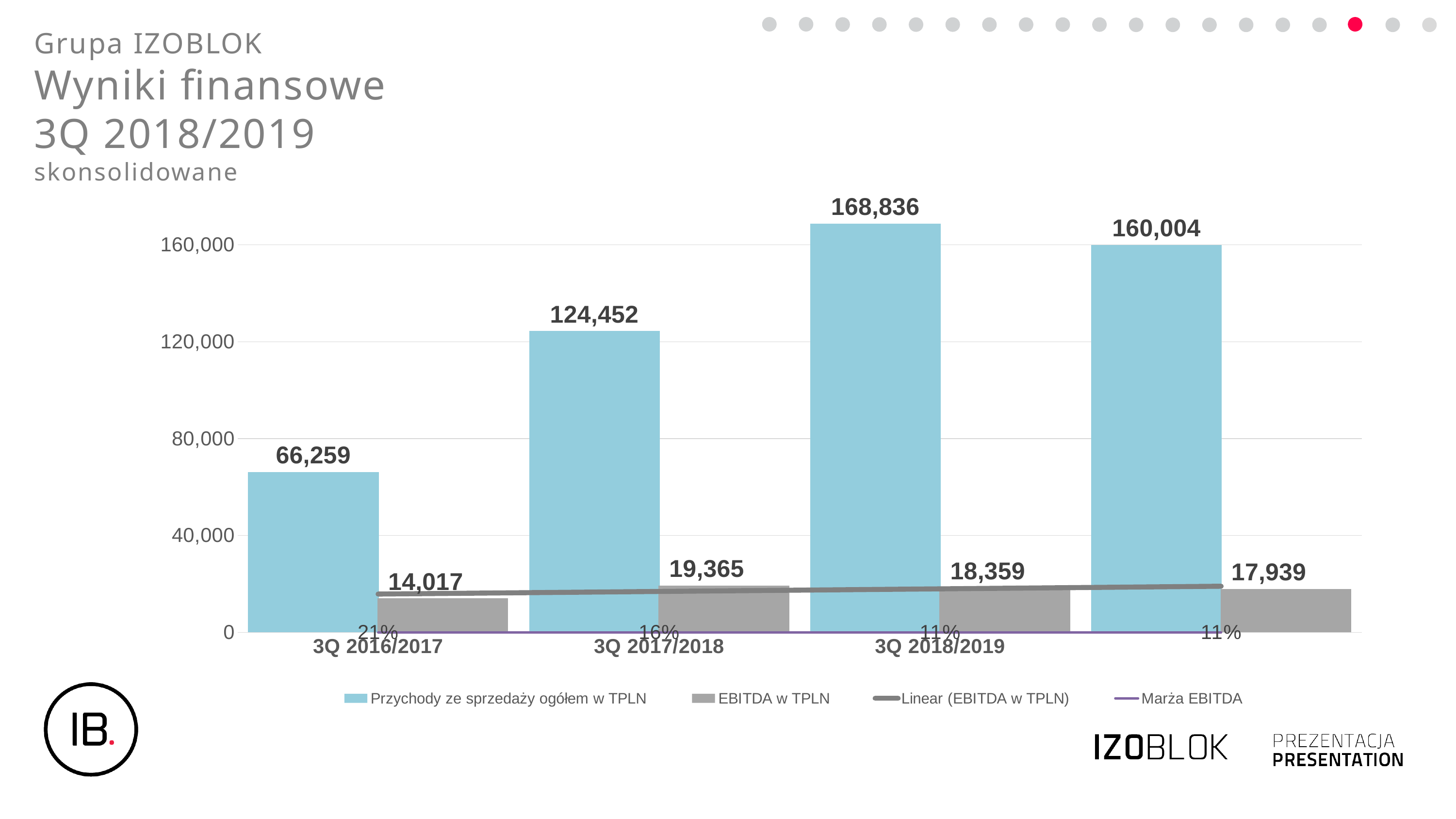
What is the difference in Przychody ze sprzedaży ogółem w TPLN between 3Q 2017/2018 and 3Q 2016/2017? 58,193 Which quarter has the lowest EBITDA w TPLN? 3Q 2016/2017 How many bar groups (periods) are plotted on the chart? 4 What is the EBITDA w TPLN value for 3Q 2017/2018? 19,365 Is the Przychody ze sprzedaży ogółem w TPLN for 3Q 2017/2018 greater or less than 120,000? greater Which labelled quarter has the highest Przychody ze sprzedaży ogółem w TPLN? 3Q 2018/2019 Which is larger: EBITDA w TPLN for 3Q 2017/2018 or for 3Q 2018/2019? 3Q 2017/2018 What is the Marża EBITDA for 3Q 2016/2017? 21% How many series does the legend list? 4 What kind of chart is used to show Przychody ze sprzedaży ogółem w TPLN and EBITDA w TPLN? Bar chart What is the EBITDA w TPLN value for 3Q 2016/2017? 14,017 What is the value of Przychody ze sprzedaży ogółem w TPLN for 3Q 2018/2019? 168,836